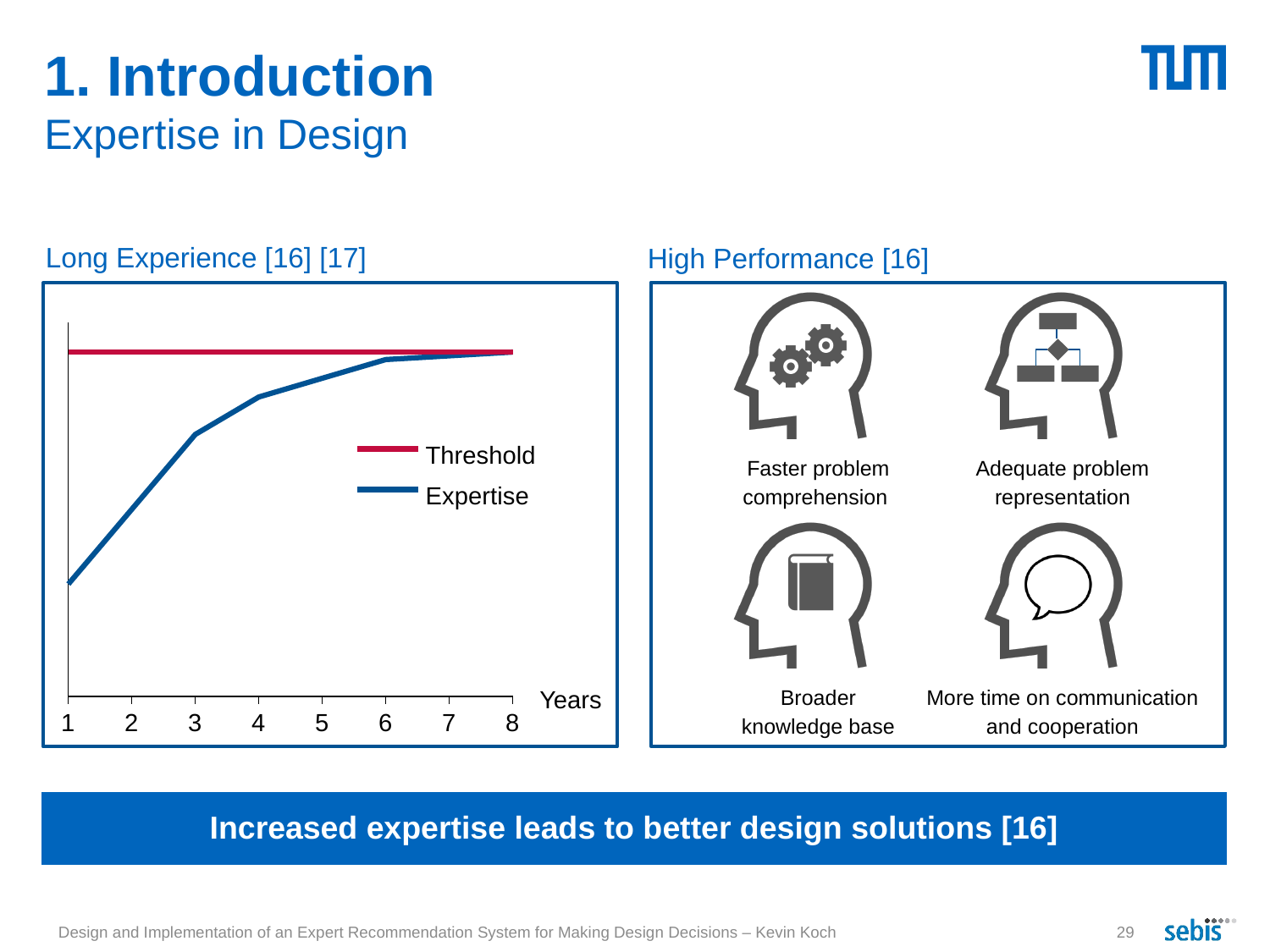
In the "Long Experience" chart, does the Threshold line rise, fall or stay flat across the years? Stay flat In the "Long Experience" chart, at which year is the Expertise value lowest? 1 In the "Long Experience" chart, is the Expertise value larger at year 2 or at year 5? Year 5 How many year values are marked on the x axis of the "Long Experience" chart? 8 How many series does the legend of the "Long Experience" chart list? 2 In the "Long Experience" chart, is the Expertise value larger at year 3 or at year 7? Year 7 Which two series are listed in the legend of the "Long Experience" chart? Threshold and Expertise What kind of chart is shown under "Long Experience [16] [17]"? Line chart In the "Long Experience" chart, does the Expertise line rise or fall as the years increase? Rise In the "Long Experience" chart, is the Expertise value at year 1 above or below the Threshold line? Below In the "Long Experience" chart, which series is drawn in red? Threshold What is the label of the x axis in the "Long Experience" chart? Years